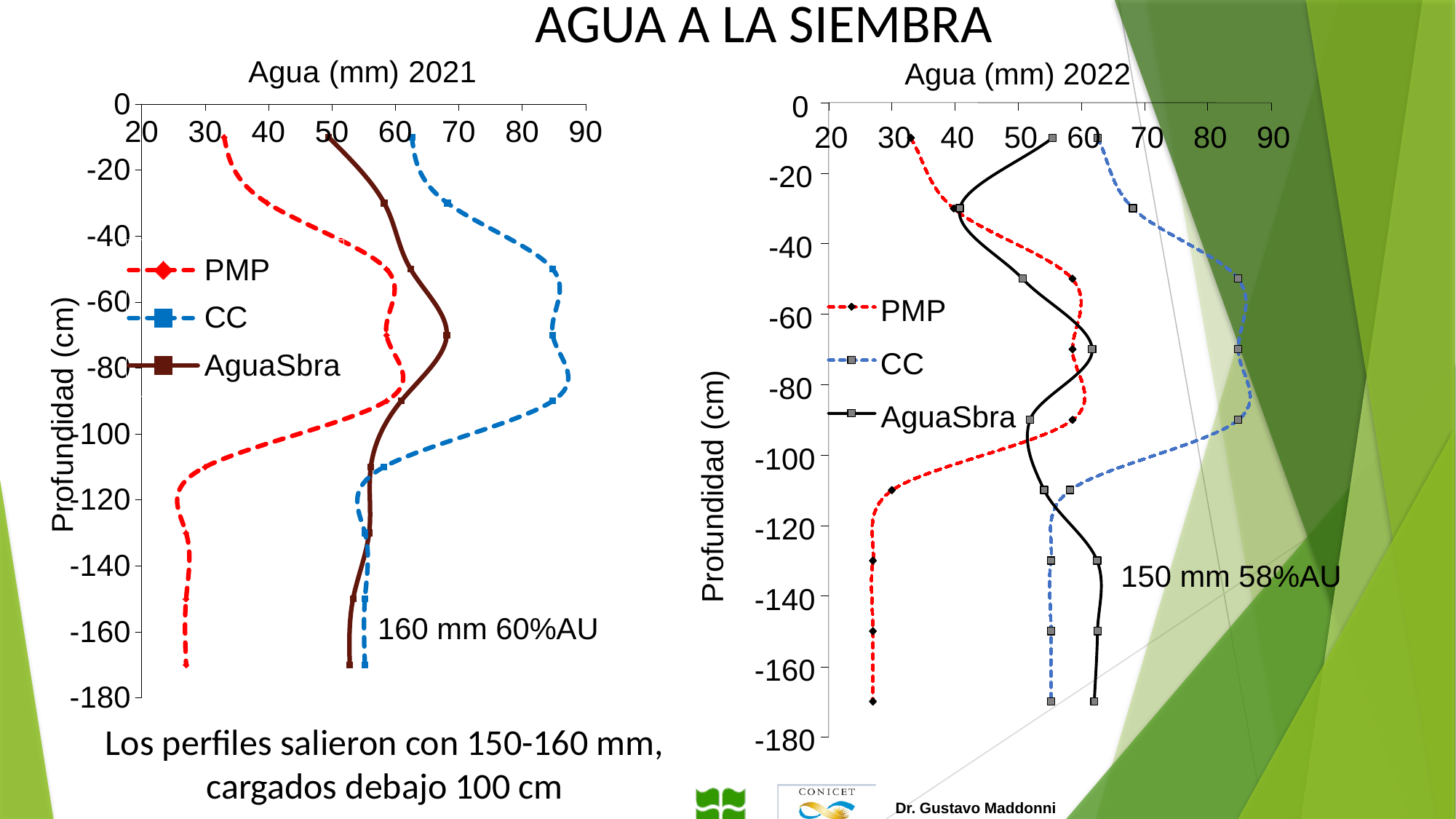
In the "Agua (mm) 2022" chart, at a depth of -50 cm, which series has the larger value, CC or AguaSbra? CC In the "Agua (mm) 2021" chart, at a depth of -80 cm, which series has the larger value, CC or PMP? CC In the "Agua (mm) 2021" chart, is the PMP value at a depth of -170 cm greater or less than 30? less What annotation text is printed on the "Agua (mm) 2022" chart? 150 mm 58%AU What kind of chart is the "Agua (mm) 2021" chart? line chart In the "Agua (mm) 2021" chart, is the CC value at a depth of -80 cm greater or less than 80? greater In the "Agua (mm) 2022" chart, is the CC value at a depth of -70 cm greater or less than 80? greater How many series does the legend of the "Agua (mm) 2022" chart list? 3 In the "Agua (mm) 2021" chart, which series are listed in the legend? PMP, CC, AguaSbra